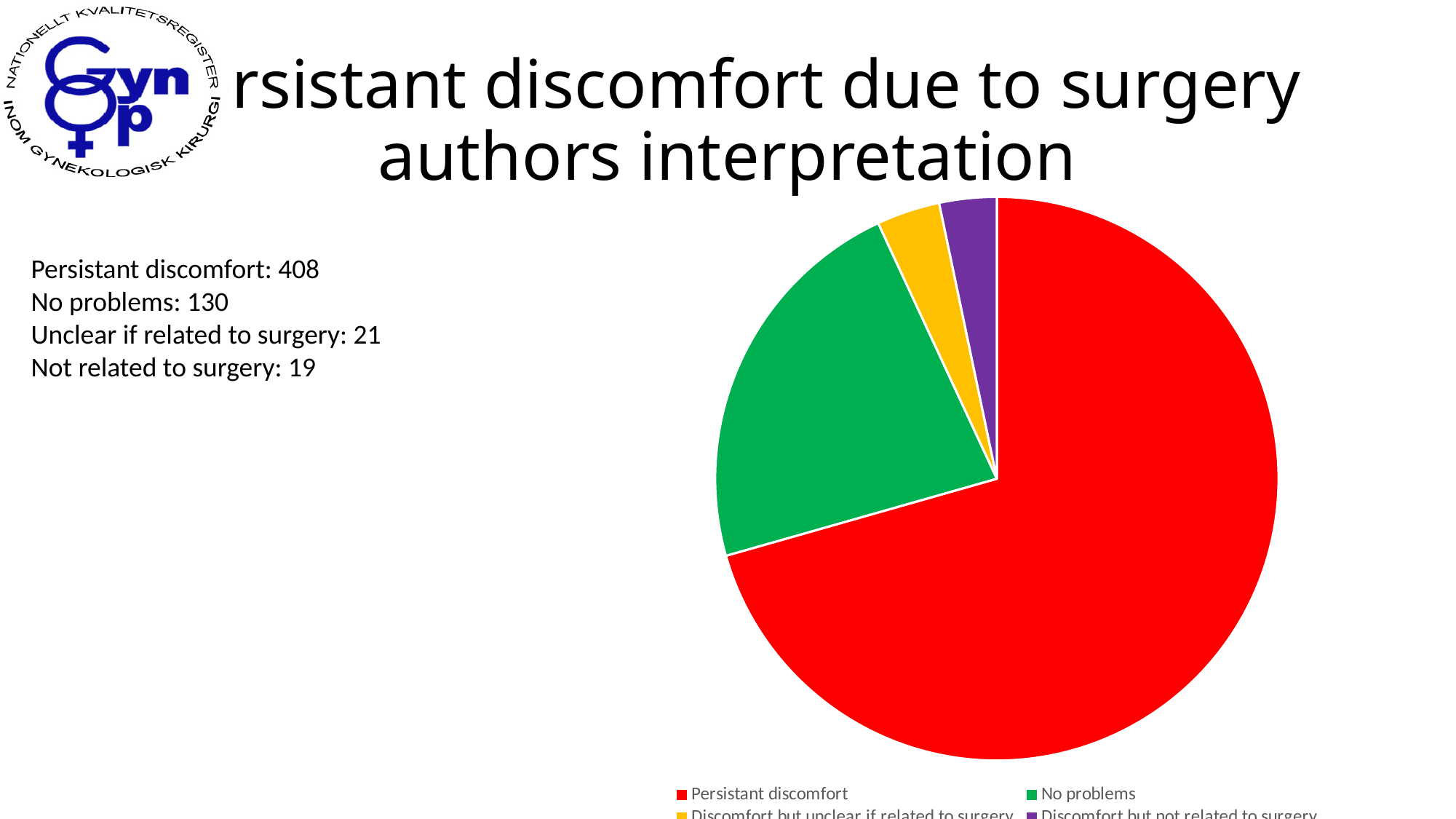
What colour is the Persistant discomfort slice? red What is the difference between the values for Persistant discomfort and No problems? 278 What is the value for Unclear if related to surgery? 21 Which category has the largest slice of the pie? Persistant discomfort What colour is the No problems slice? green What is the value for Persistant discomfort? 408 Which category has the smallest value? Not related to surgery What kind of chart is shown on the slide? pie chart What is the value for No problems? 130 What is the value for Not related to surgery? 19 How many slices does the pie chart have? 4 Which is larger, the value for Unclear if related to surgery or the value for Not related to surgery? Unclear if related to surgery